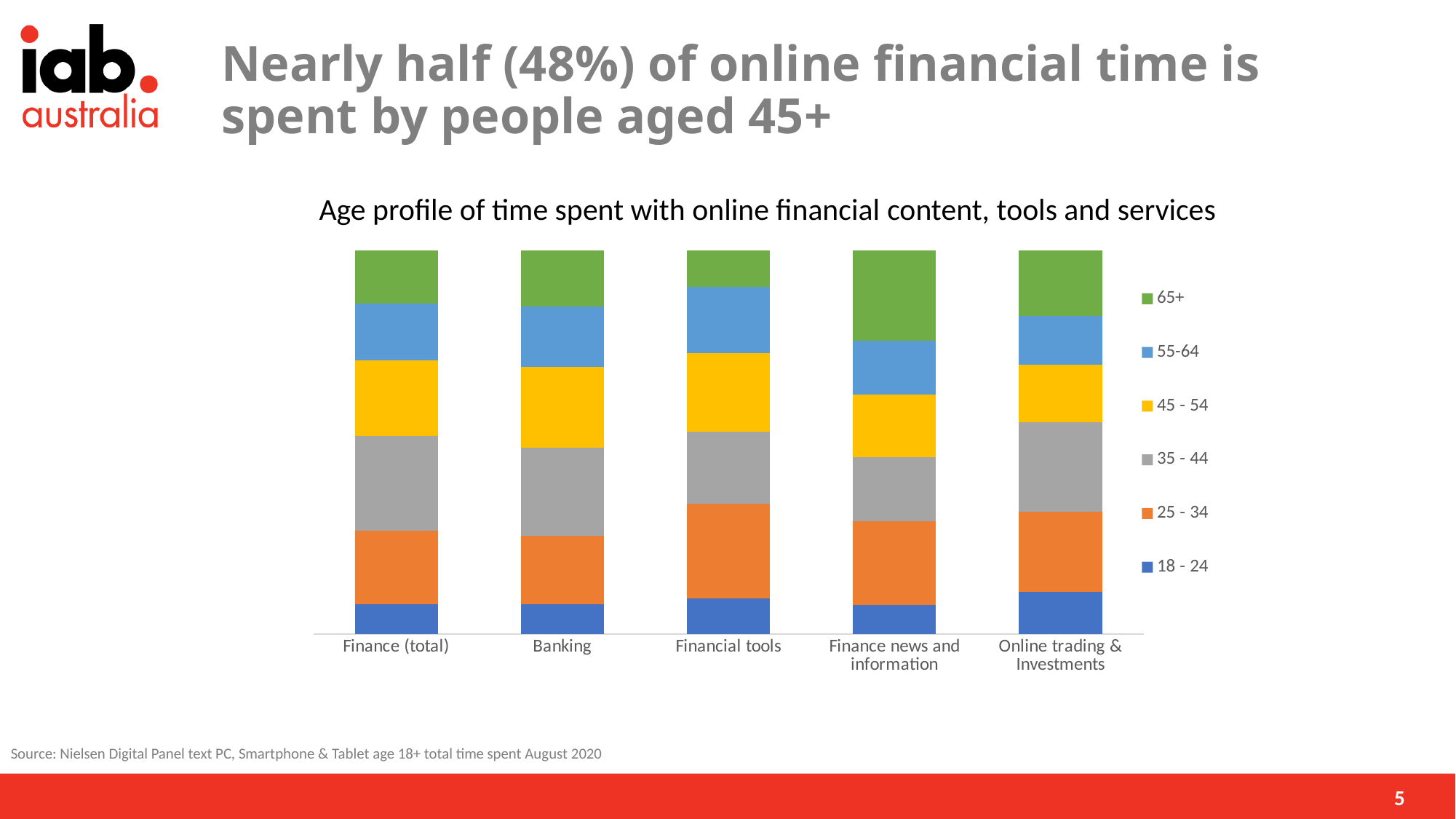
Is the 65+ segment larger for Finance news and information or for Financial tools? Finance news and information Which category has the smallest 65+ segment in its bar? Financial tools Is the 25 - 34 segment larger for Financial tools or for Banking? Financial tools What kind of chart is shown on the slide? Stacked bar chart How many age groups does the chart's legend list? 6 Which category has the largest 25 - 34 segment in its bar? Financial tools Which category has the largest 55-64 segment in its bar? Financial tools Which category has the largest 65+ segment in its bar? Finance news and information What is the title of the chart? Age profile of time spent with online financial content, tools and services Which colour represents the 45 - 54 age group in the chart? Yellow How many categories are shown along the x axis of the chart? 5